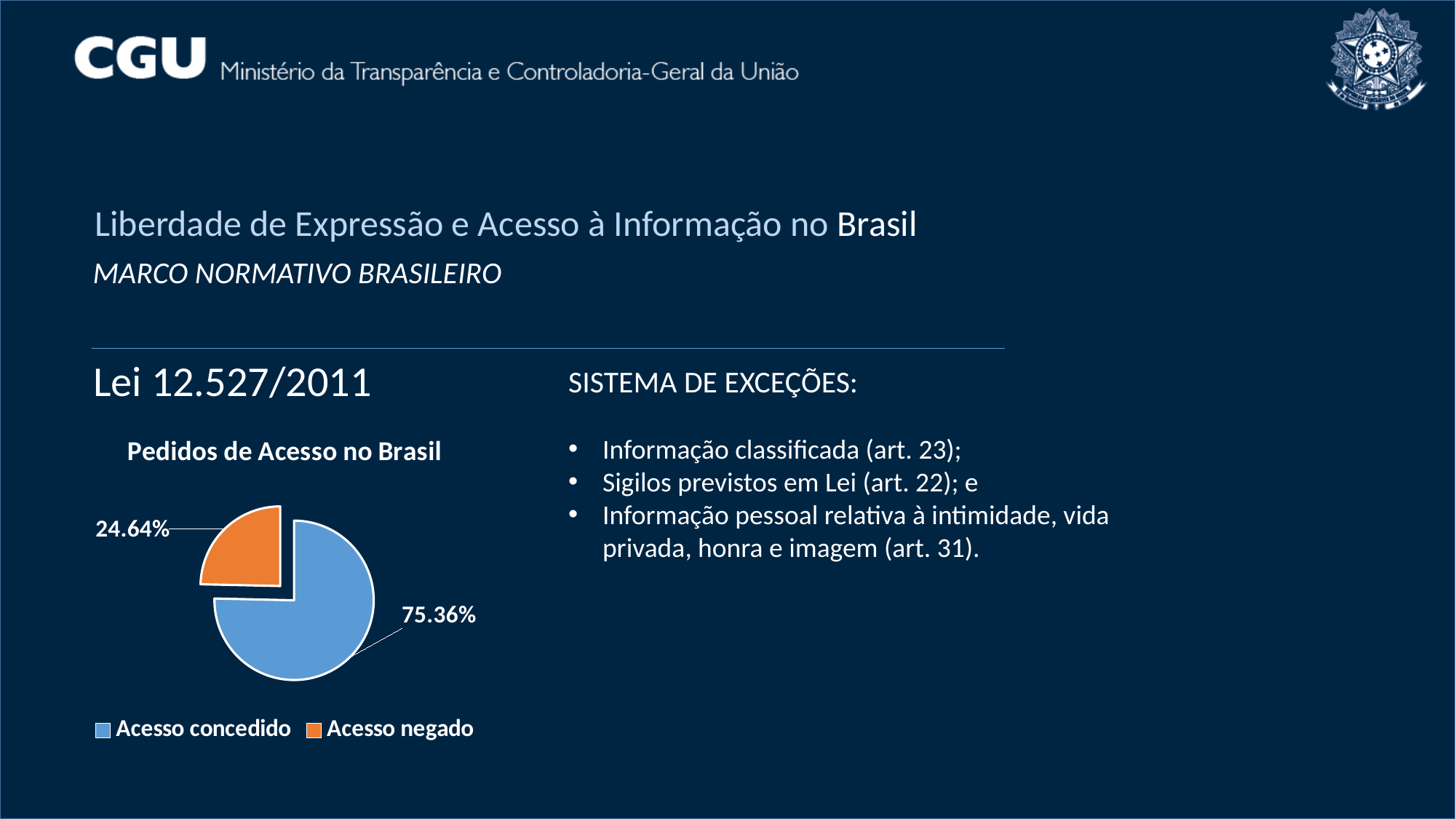
Which is larger, Acesso concedido or Acesso negado? Acesso concedido Is the share for Acesso concedido greater or less than 50%? greater How many slices does the pie chart have? 2 Which slice of the pie is the largest? Acesso concedido What share of the pie is labelled Acesso concedido? 75.36% What colour is the Acesso negado slice? orange What is the difference between the Acesso concedido and Acesso negado shares? 50.72% What is the title of the chart? Pedidos de Acesso no Brasil Which slice of the pie is the smallest? Acesso negado What kind of chart is shown on the slide? pie chart How many entries does the legend list? 2 What share of the pie is labelled Acesso negado? 24.64%